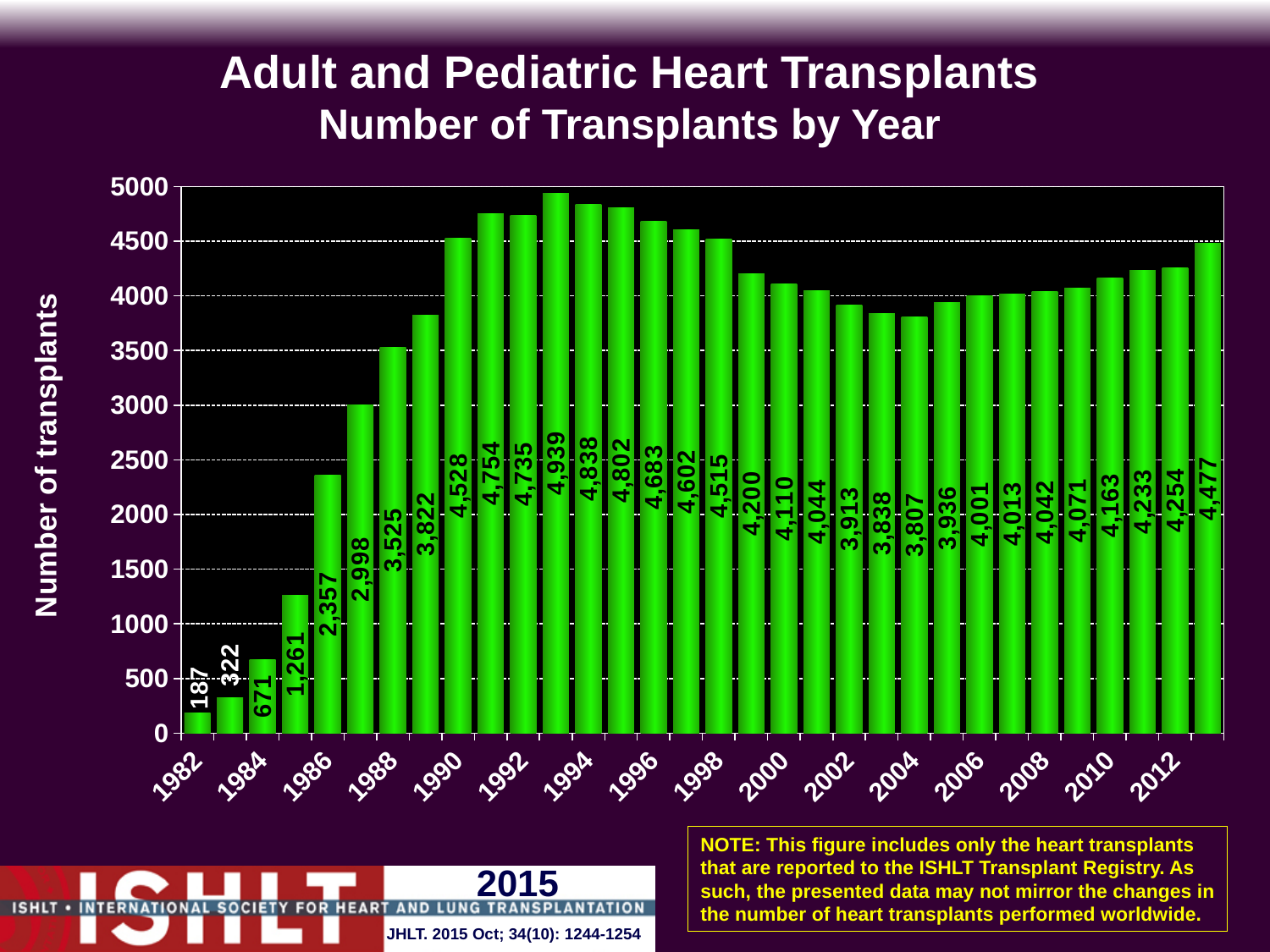
What is the number of transplants for 2012? 4,254 What is the label of the y axis? Number of transplants Which year has more transplants, 2000 or 2010? 2010 What kind of chart is shown on the slide? Bar chart What is the highest number of transplants shown on the chart? 4,939 What is the number of transplants for 2004? 3,807 What is the difference in the number of transplants between 1988 and 1986? 1,168 Is the value for 1994 greater or less than 4500? greater What is the number of transplants for 1990? 4,528 Which year has the lowest number of transplants? 1982 How many bars are shown on the chart? 32 What is the number of transplants for 1982? 187